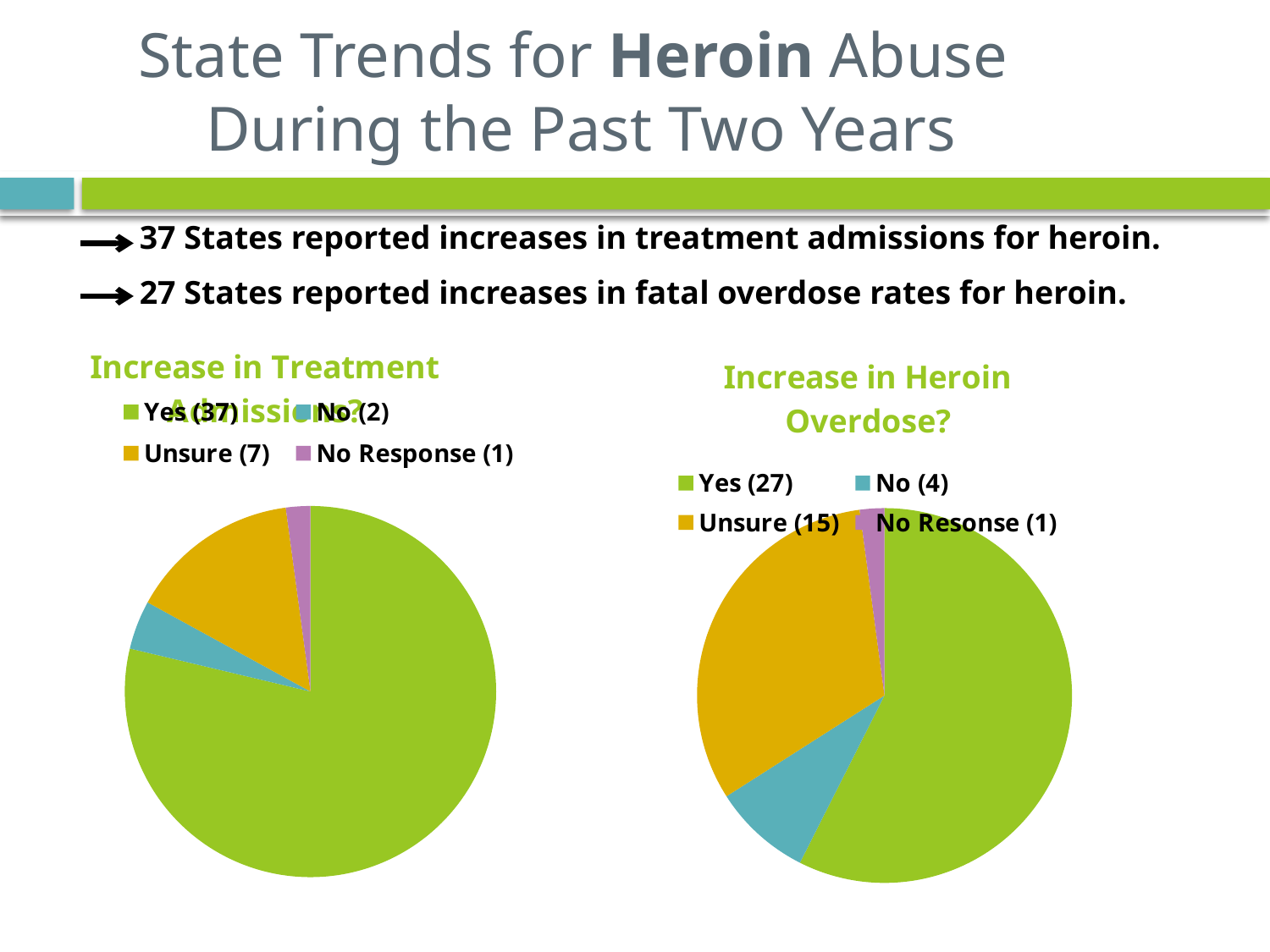
Which chart has more states answering Unsure, the 'Increase in Treatment Admissions?' chart or the 'Increase in Heroin Overdose?' chart? Increase in Heroin Overdose? In the 'Increase in Heroin Overdose?' chart, how many states answered Unsure? 15 How many categories does the 'Increase in Treatment Admissions?' chart show? 4 In the 'Increase in Treatment Admissions?' chart, what colour is the Unsure slice? Yellow/gold What is the total number of responses in the 'Increase in Heroin Overdose?' chart? 47 In the 'Increase in Heroin Overdose?' chart, which response has the smallest slice? No Resonse (1) In the 'Increase in Treatment Admissions?' chart, what is the difference between the Yes and Unsure counts? 30 What type of chart is the 'Increase in Heroin Overdose?' chart? Pie chart In the 'Increase in Heroin Overdose?' chart, how many states answered No? 4 In the 'Increase in Heroin Overdose?' chart, what is the difference between the Yes and Unsure counts? 12 In the 'Increase in Treatment Admissions?' chart, which response has the largest slice? Yes (37) In the 'Increase in Treatment Admissions?' chart, how many states answered Yes? 37